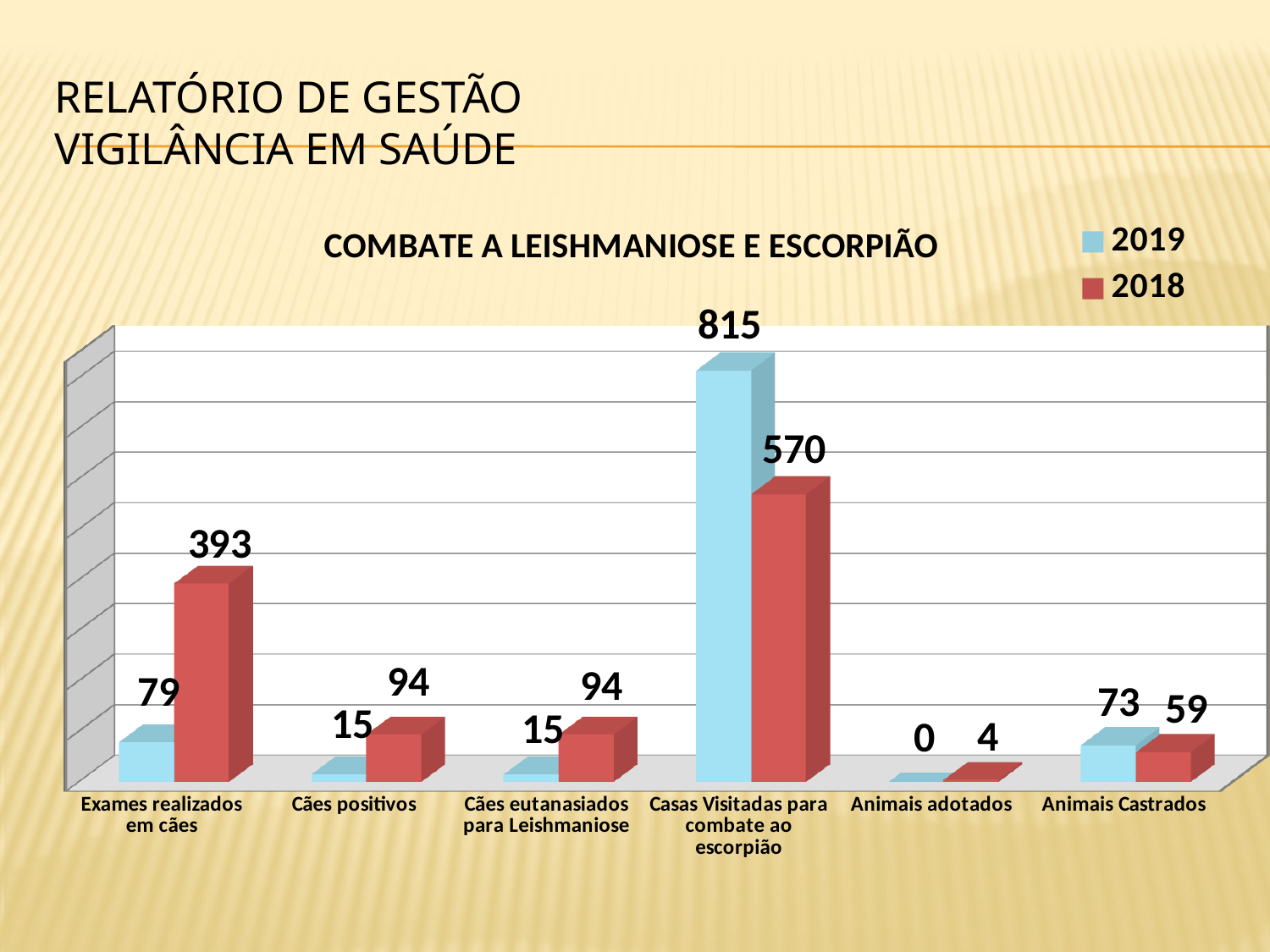
What kind of chart is shown on the slide? Bar chart How many series does the legend list? 2 What is the difference between the 2018 and 2019 values for Exames realizados em cães? 314 Which is larger for Animais Castrados, the 2019 value or the 2018 value? 2019 What is the 2019 value for Animais Castrados? 73 Which category has the highest 2019 value? Casas Visitadas para combate ao escorpião Which category has the lowest 2018 value? Animais adotados What is the 2018 value for Exames realizados em cães? 393 What is the 2018 value for Cães positivos? 94 How many categories are shown on the x axis? 6 What is the 2019 value for Casas Visitadas para combate ao escorpião? 815 What is the difference between the 2019 and 2018 values for Casas Visitadas para combate ao escorpião? 245